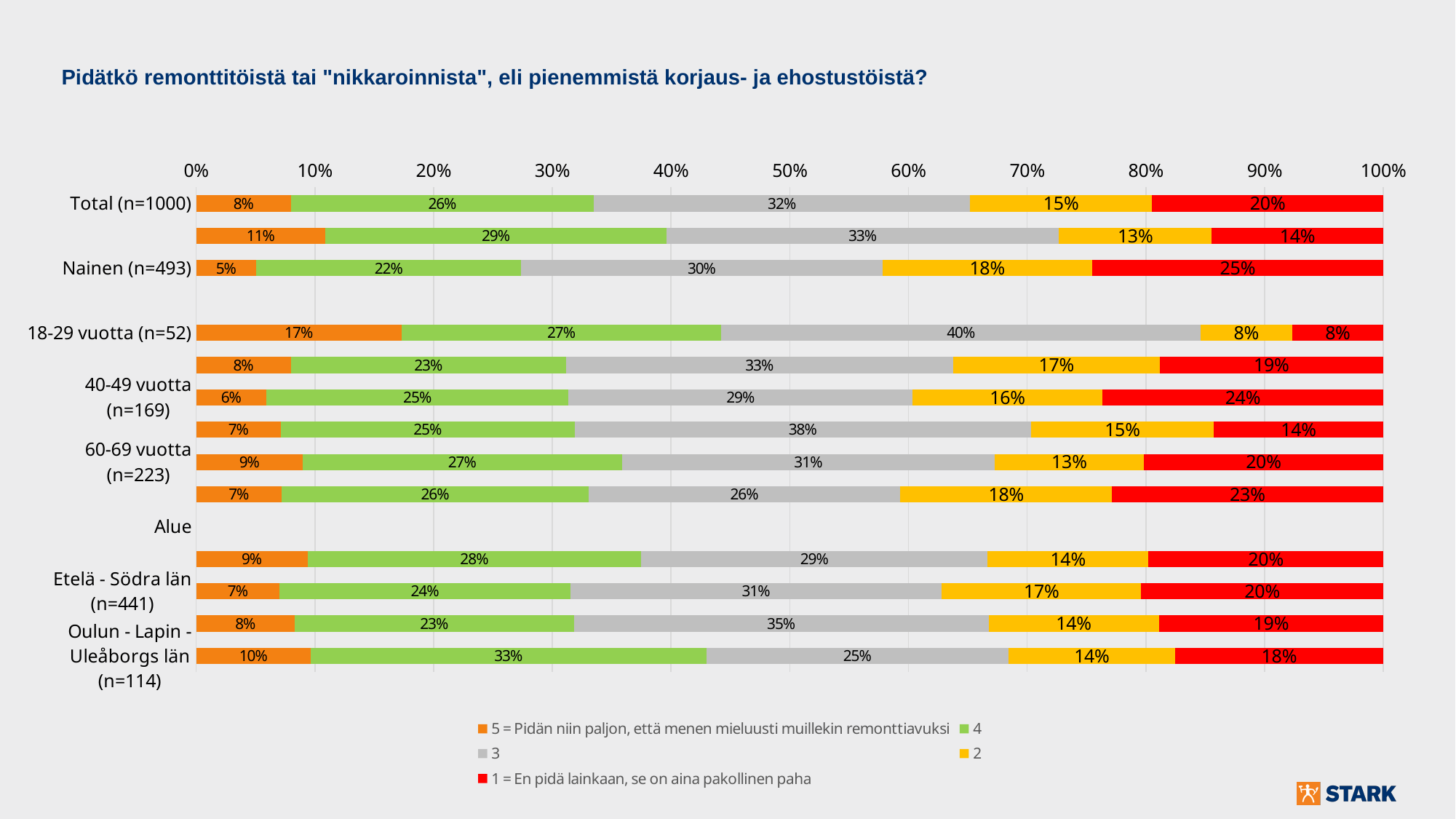
What share of 18-29 vuotta (n=52) answered 5 = Pidän niin paljon, että menen mieluusti muillekin remonttiavuksi? 17% What share of the Total (n=1000) group answered 3? 32% What is the title of the chart? Pidätkö remonttitöistä tai "nikkaroinnista", eli pienemmistä korjaus- ja ehostustöistä? What colour represents the answer 3 in the chart? Grey What share of 18-29 vuotta (n=52) answered 3? 40% How many series does the legend list? 5 What kind of chart is shown on the slide? Stacked bar chart What share of Nainen (n=493) answered 5 = Pidän niin paljon, että menen mieluusti muillekin remonttiavuksi? 5% What share of the Total (n=1000) group answered 1 = En pidä lainkaan, se on aina pakollinen paha? 20% Which is larger: the share of 18-29 vuotta (n=52) answering 4 or the share of Nainen (n=493) answering 4? 18-29 vuotta (n=52) What is the difference between the share of Nainen (n=493) answering 1 and the share of Total (n=1000) answering 1? 5% What share of Nainen (n=493) answered 1 = En pidä lainkaan, se on aina pakollinen paha? 25%